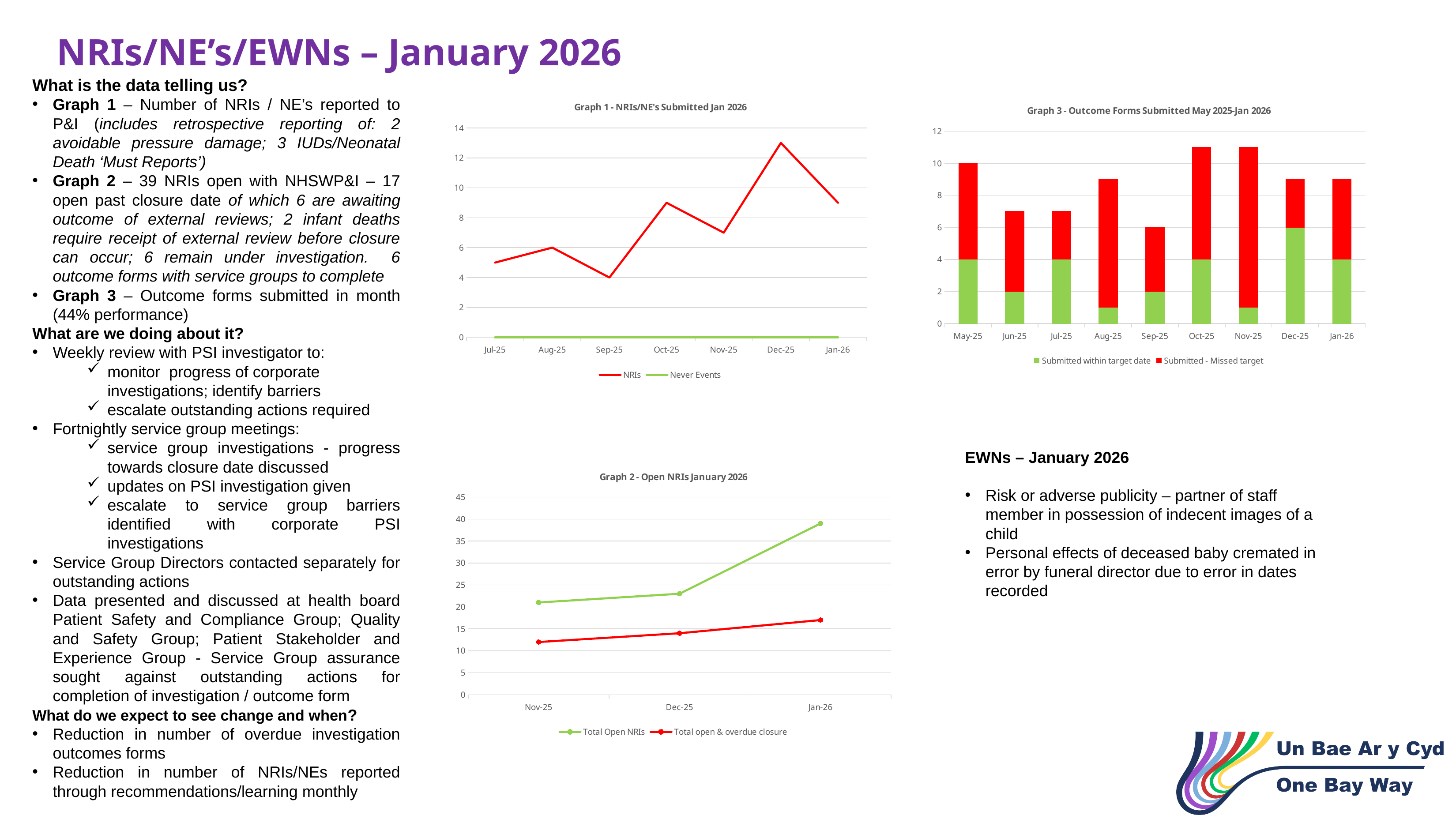
In Graph 1 - NRIs/NE's Submitted Jan 2026, which month has the lowest number of NRIs? Sep-25 How many months are shown on the x axis of Graph 3 - Outcome Forms Submitted May 2025-Jan 2026? 9 In Graph 3 - Outcome Forms Submitted May 2025-Jan 2026, which month has the lowest total number of outcome forms submitted? Sep-25 In Graph 2 - Open NRIs January 2026, is the Total Open NRIs value for Jan-26 greater or less than 35? greater What kind of chart is Graph 1 - NRIs/NE's Submitted Jan 2026? line chart How many months are plotted on the x axis of Graph 1 - NRIs/NE's Submitted Jan 2026? 7 In Graph 2 - Open NRIs January 2026, does the Total Open NRIs line rise or fall from Nov-25 to Jan-26? rise In Graph 1 - NRIs/NE's Submitted Jan 2026, is the NRIs value for Dec-25 greater or less than 12? greater In Graph 1 - NRIs/NE's Submitted Jan 2026, which month has the highest number of NRIs? Dec-25 In Graph 1 - NRIs/NE's Submitted Jan 2026, how many series does the legend list? 2 What kind of chart is Graph 2 - Open NRIs January 2026? line chart What kind of chart is Graph 3 - Outcome Forms Submitted May 2025-Jan 2026? bar chart